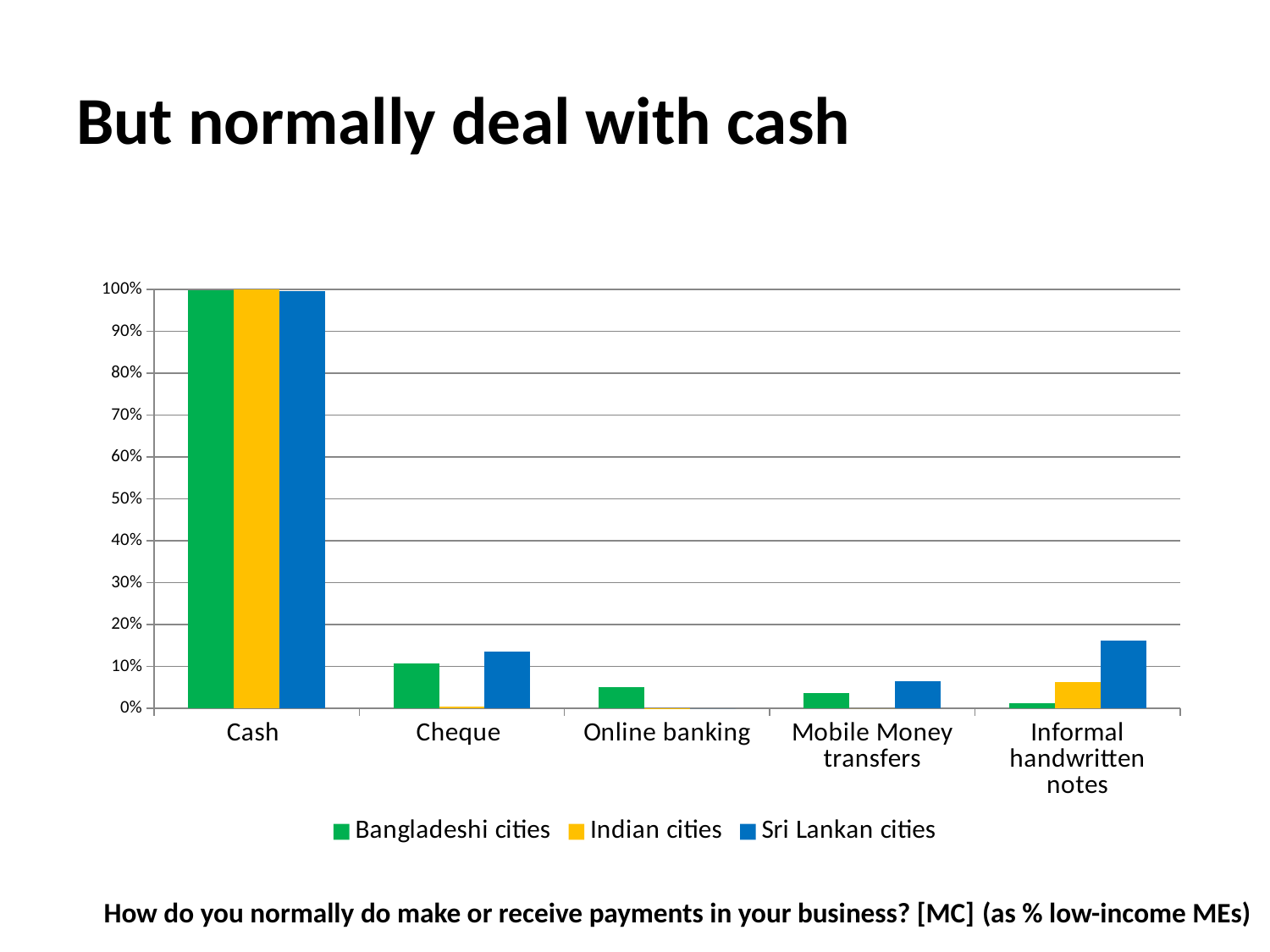
How many series does the legend list? 3 Is the value for Indian cities for Cash greater or less than 90%? greater For Cheque, which is larger: the value for Bangladeshi cities or the value for Indian cities? Bangladeshi cities For Informal handwritten notes, which is larger: the value for Sri Lankan cities or the value for Bangladeshi cities? Sri Lankan cities Which series is shown in blue in the legend? Sri Lankan cities How many payment method categories are shown on the x axis? 5 What is the title of the slide? But normally deal with cash Which payment method has the highest value for Sri Lankan cities? Cash Is the value for Sri Lankan cities for Informal handwritten notes greater or less than 10%? greater Which payment method has the highest value for Bangladeshi cities? Cash What kind of chart is shown on the slide? bar chart Is the value for Bangladeshi cities for Cheque greater or less than 20%? less